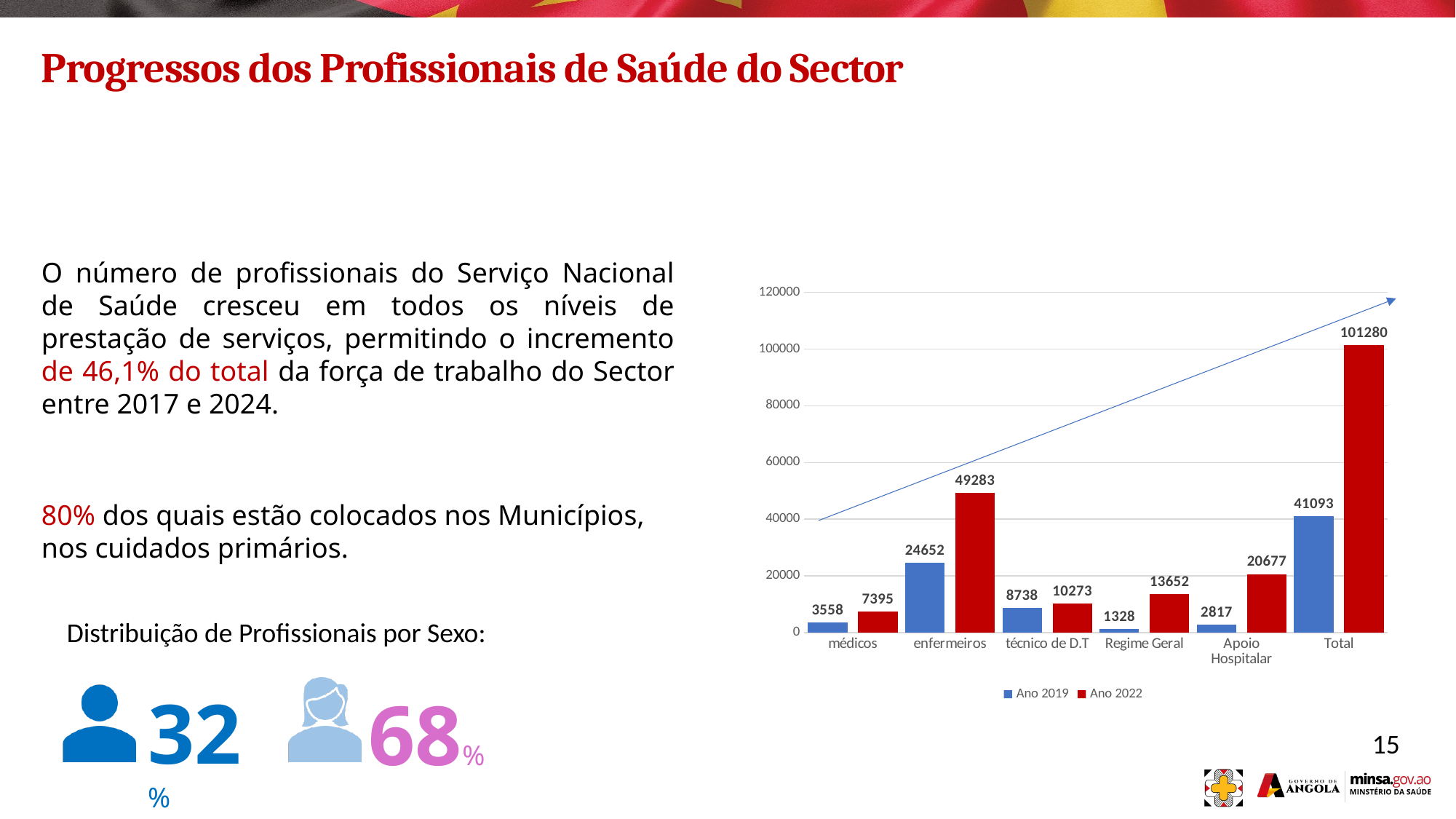
Which colour represents the Ano 2022 series in the chart? red How many categories are shown on the x axis of the chart? 6 What is the value for Apoio Hospitalar in the Ano 2022 series? 20677 What kind of chart is shown on the slide? bar chart Is the Ano 2022 value for Total greater or less than 100000? greater What is the value for enfermeiros in the Ano 2022 series? 49283 What is the difference between the Ano 2022 and Ano 2019 values for Regime Geral? 12324 What is the value for médicos in the Ano 2019 series? 3558 How many series does the chart legend list? 2 Which category has the lowest value in the Ano 2019 series? Regime Geral Excluding the Total category, which category has the highest value in the Ano 2019 series? enfermeiros Which is larger: the Ano 2019 value for técnico de D.T or the Ano 2022 value for médicos? Ano 2019 value for técnico de D.T